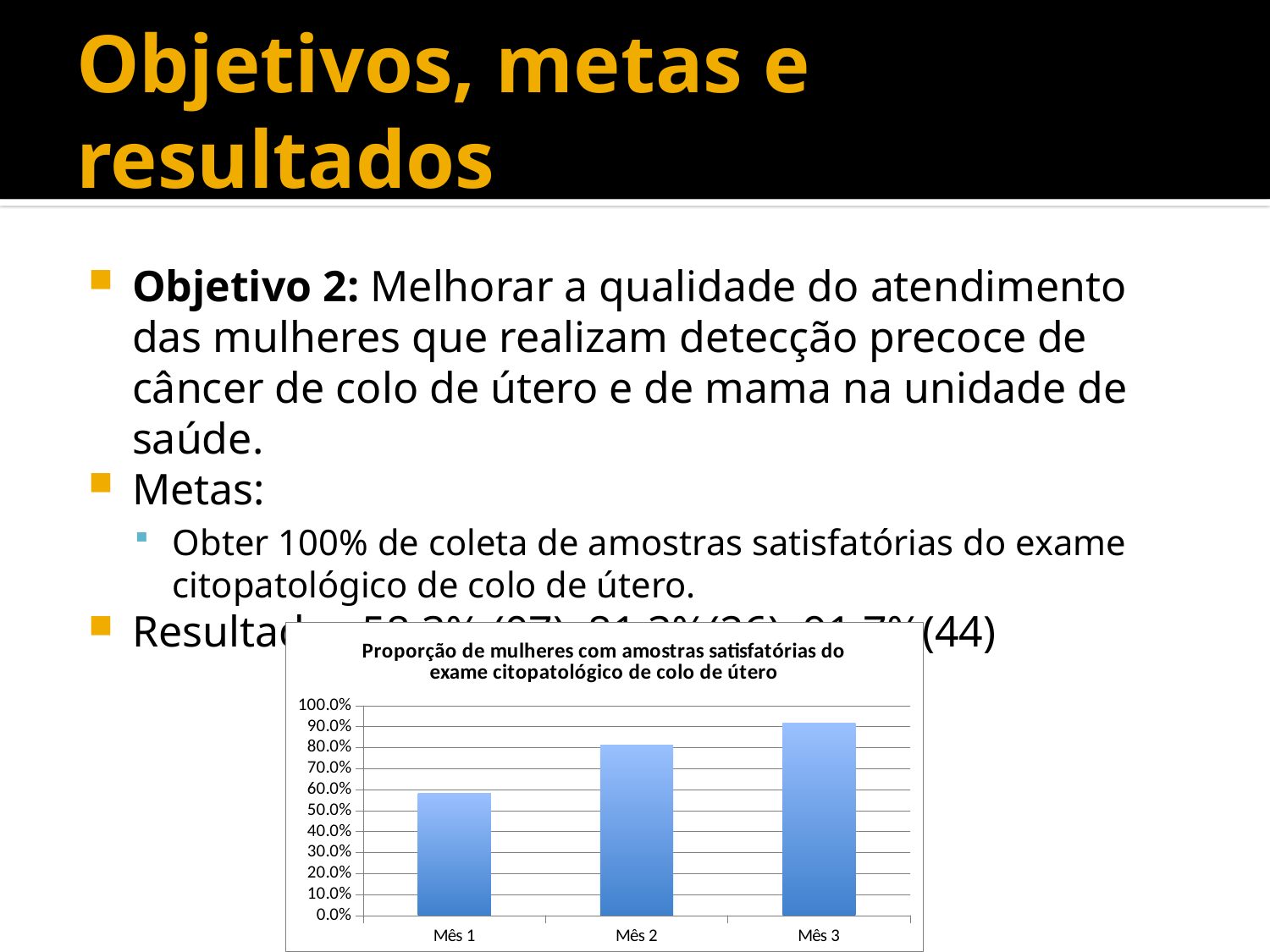
Is the value for Mês 2 greater or less than 70.0%? greater Which month has the highest bar in the chart? Mês 3 Which month has the lowest bar in the chart? Mês 1 What is the maximum value shown on the y axis of the chart? 100.0% What kind of chart is shown on the slide? bar chart Is the value for Mês 3 greater or less than 80.0%? greater Is the value for Mês 1 greater or less than 70.0%? less What is the title of the chart? Proporção de mulheres com amostras satisfatórias do exame citopatológico de colo de útero Which is larger, the value for Mês 1 or the value for Mês 2? Mês 2 How many categories are plotted on the x axis of the chart? 3 Do the values rise or fall from Mês 1 to Mês 3? rise